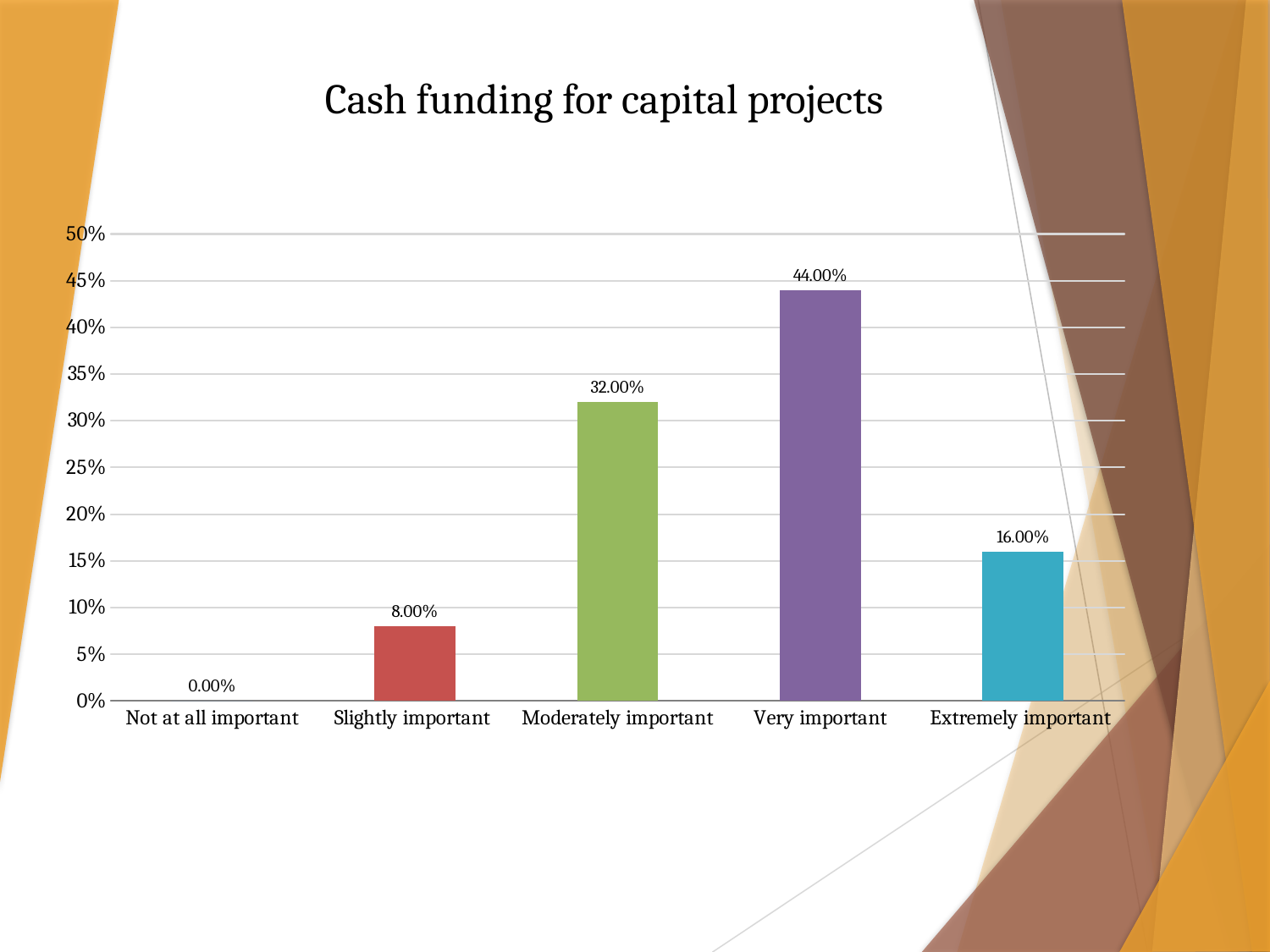
How many categories are shown on the x axis? 5 What is the title of the chart? Cash funding for capital projects What is the value for Moderately important? 32.00% Which is larger, the value for Extremely important or the value for Slightly important? Extremely important Is the value for Moderately important greater or less than 30%? greater What is the value for Slightly important? 8.00% What is the value for Very important? 44.00% What kind of chart is shown on the slide? bar chart Which category has the highest value? Very important What is the value for Extremely important? 16.00% What is the difference between the values for Very important and Moderately important? 12.00% Which category has the lowest value? Not at all important